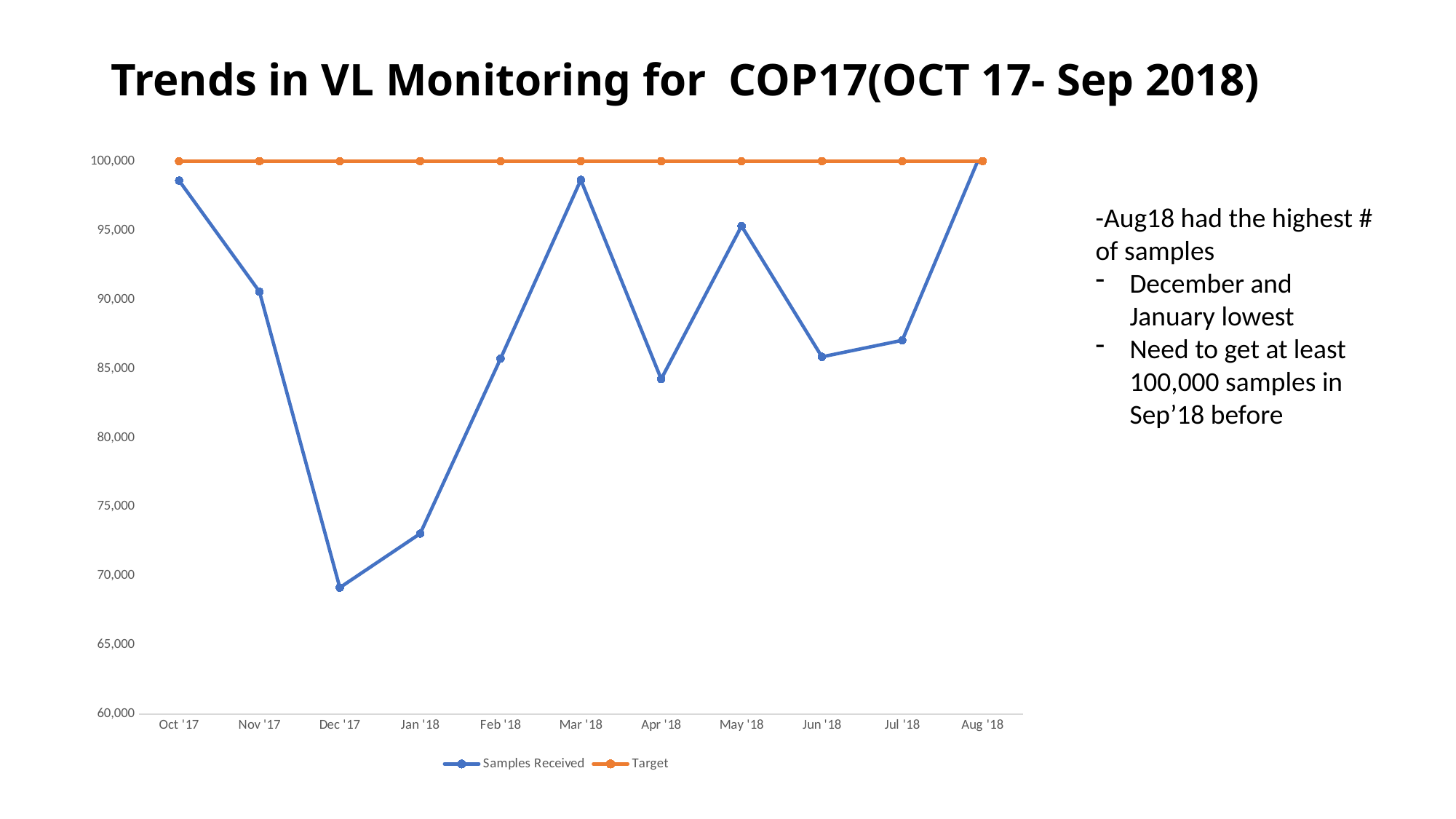
What is the Target value for Oct '17? 100,000 What kind of chart is shown on the slide? line chart Is the Samples Received value for Apr '18 greater or less than 85,000? less How many series does the legend list? 2 What colour is the Target line? orange How many months are plotted along the x axis? 11 Which month has a larger Samples Received value, Nov '17 or Feb '18? Nov '17 Is the Samples Received value for Dec '17 greater or less than 70,000? less Do the Samples Received values rise or fall from Oct '17 to Dec '17? fall In which month is the Samples Received value lowest? Dec '17 Is the Samples Received value for Mar '18 greater or less than 95,000? greater In which month is the Samples Received value highest? Aug '18